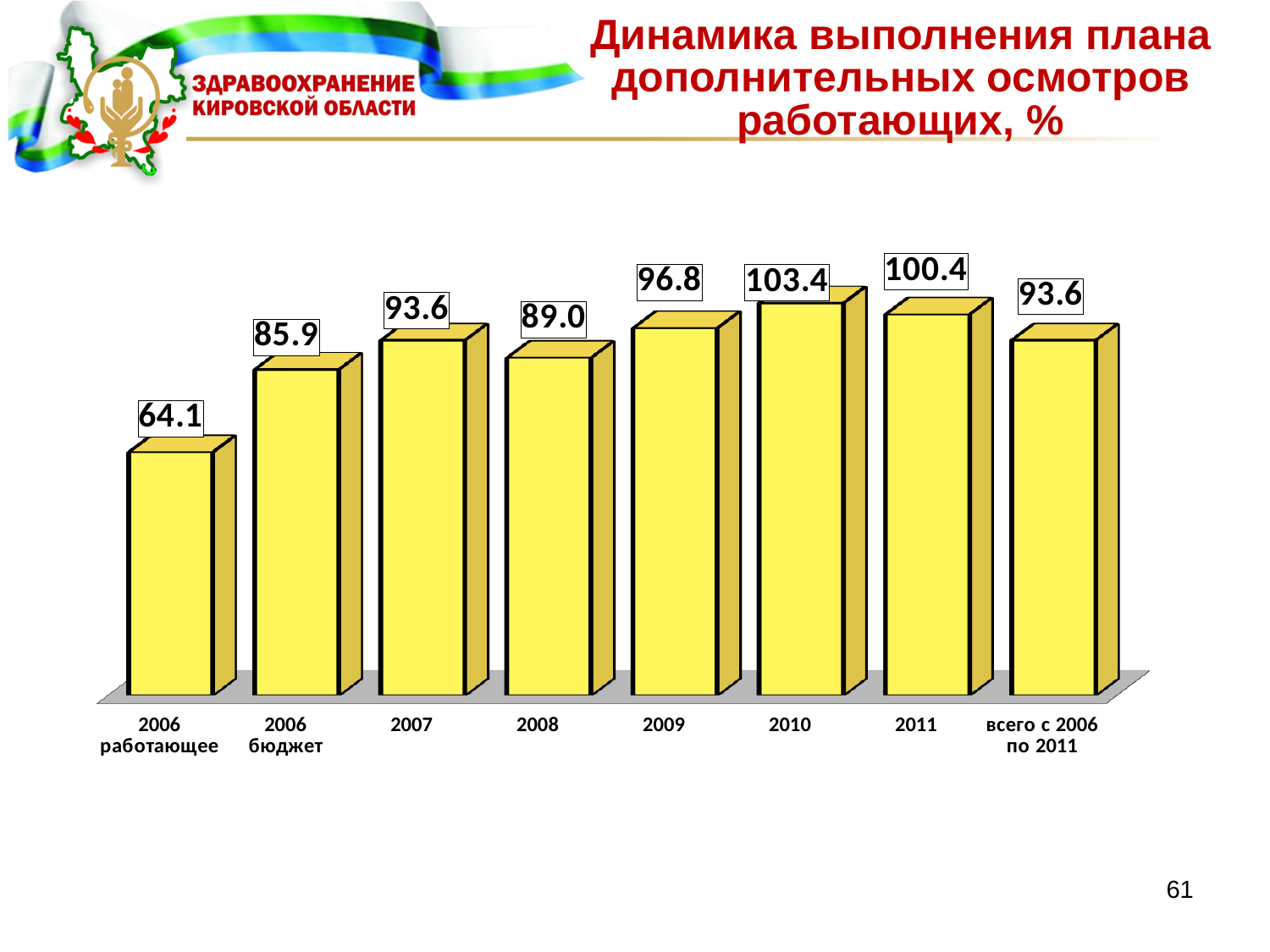
What is the value for 2008? 89.0 What is the value for 2010? 103.4 What kind of chart is shown on the slide? bar chart Which category has the highest value? 2010 What is the value for 2006 работающее? 64.1 How many bars are shown in the chart? 8 What is the value for всего с 2006 по 2011? 93.6 What is the difference between the values for 2006 бюджет and 2006 работающее? 21.8 What is the title of the chart? Динамика выполнения плана дополнительных осмотров работающих, % Which is larger, the value for 2009 or the value for 2008? 2009 What is the difference between the values for 2010 and 2011? 3.0 Which category has the lowest value? 2006 работающее